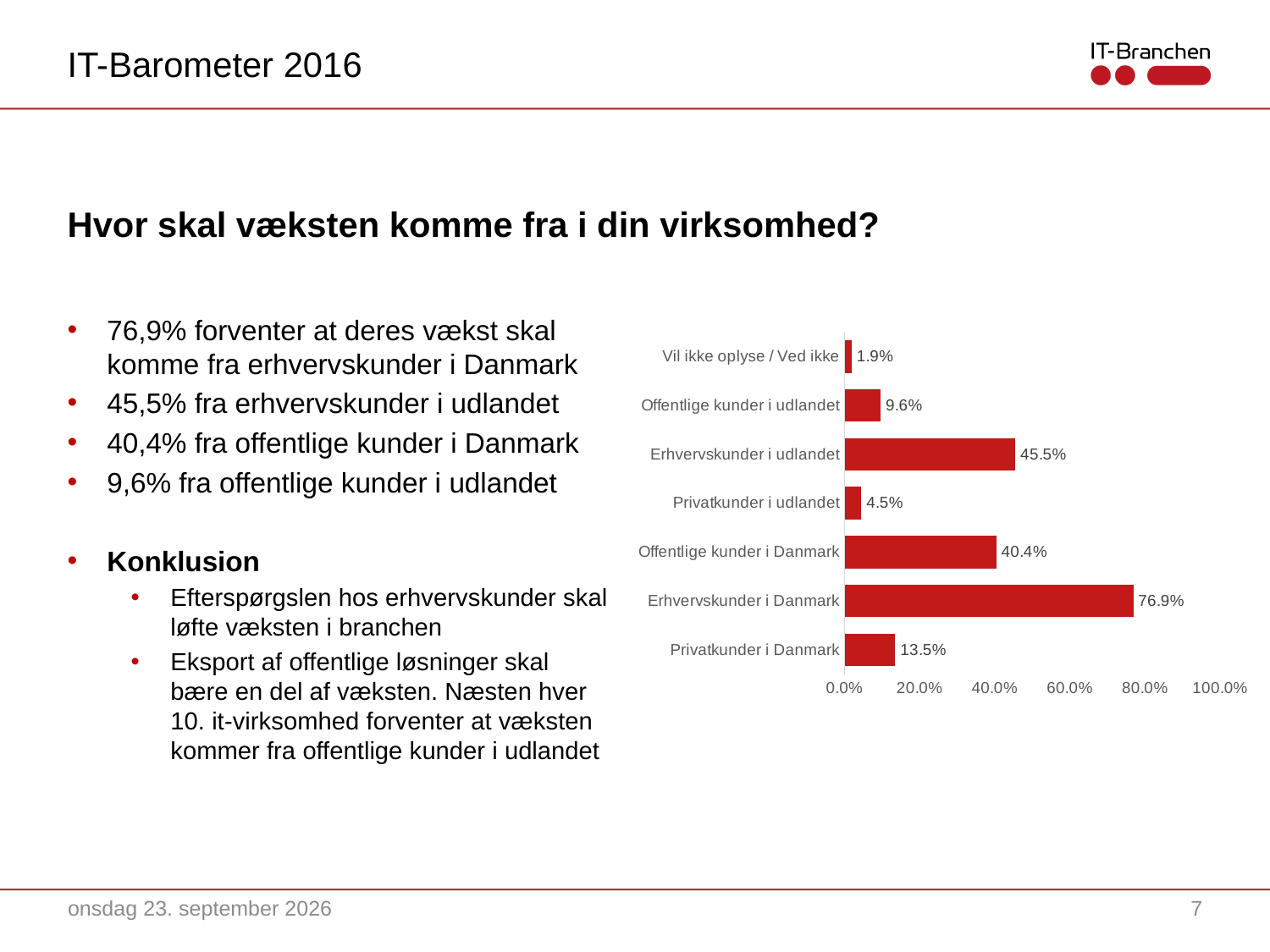
What is the difference between Erhvervskunder i Danmark and Erhvervskunder i udlandet? 31.4% Which is larger, Privatkunder i Danmark or Privatkunder i udlandet? Privatkunder i Danmark What is the value for Erhvervskunder i Danmark? 76.9% Which category has the highest value? Erhvervskunder i Danmark What colour are the bars in the chart? red What is the value for Privatkunder i Danmark? 13.5% What kind of chart is shown on the slide? bar chart Is the value for Offentlige kunder i Danmark greater or less than 60.0%? less Which category has the lowest value? Vil ikke oplyse / Ved ikke How many categories are shown in the chart? 7 What is the difference between Erhvervskunder i udlandet and Offentlige kunder i Danmark? 5.1% What is the value for Offentlige kunder i udlandet? 9.6%